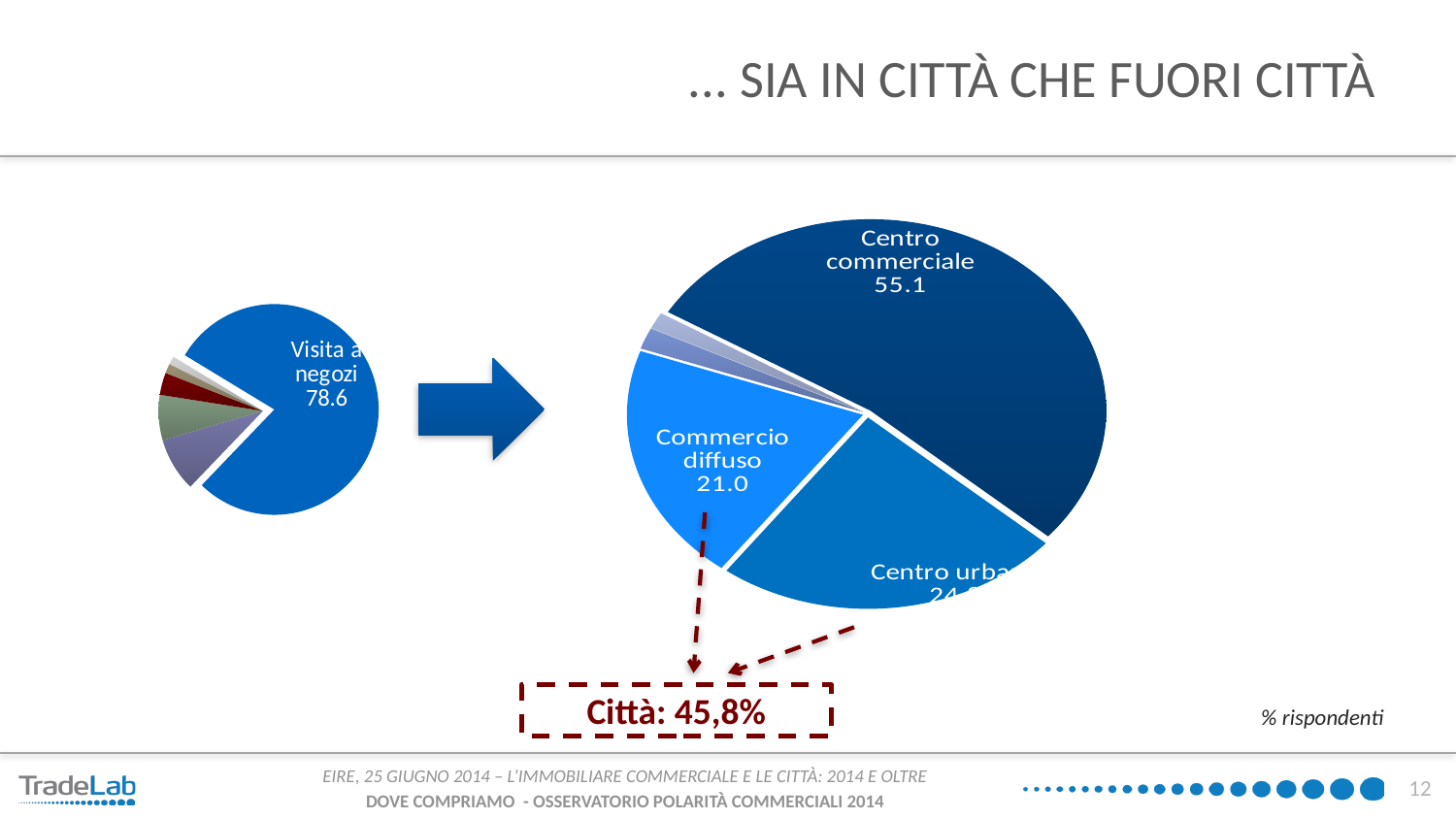
What value is shown in the dashed box below the right pie chart? Città: 45,8% In the left pie chart, does the Visita a negozi slice account for more or less than half of the pie? More than half How many charts are shown on the slide? 2 In the right pie chart, which is larger: Centro urbano or Commercio diffuso? Centro urbano In the left pie chart, what is the value shown for Visita a negozi? 78.6 What type of chart is used on this slide? Pie chart In the right pie chart, what is the value shown for Commercio diffuso? 21.0 In the right pie chart, which labeled slice is the largest? Centro commerciale In the right pie chart, what is the difference between the values for Centro commerciale and Commercio diffuso? 34.1 In the right pie chart, what is the value shown for Centro commerciale? 55.1 What unit note appears at the bottom right of the chart area? % rispondenti In the right pie chart, which is larger: Centro commerciale or Commercio diffuso? Centro commerciale